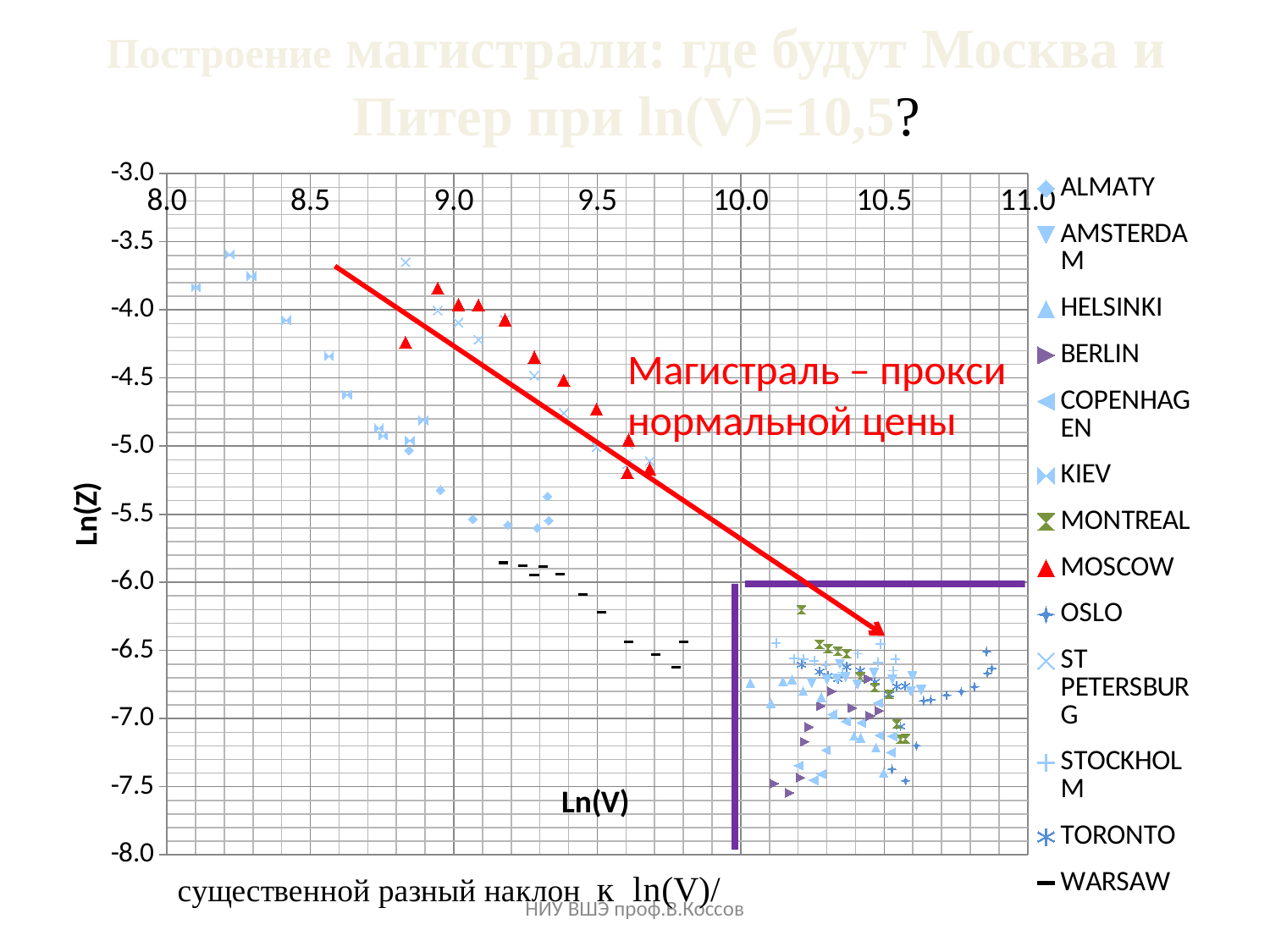
Do the MOSCOW points rise or fall in Ln(Z) as Ln(V) increases? fall Are the Ln(Z) values for BERLIN greater or less than -6.0? less How many series does the legend list? 13 Are the Ln(Z) values for MOSCOW greater or less than -5.5? greater Are the Ln(V) values for WARSAW greater or less than 10.0? less Which series is plotted at higher Ln(Z) values, MOSCOW or BERLIN? MOSCOW What is the title of the horizontal axis? Ln(V) What kind of chart is shown on the slide? scatter chart Which series is plotted at lower Ln(Z) values, WARSAW or MOSCOW? WARSAW What is the title of the vertical axis? Ln(Z)